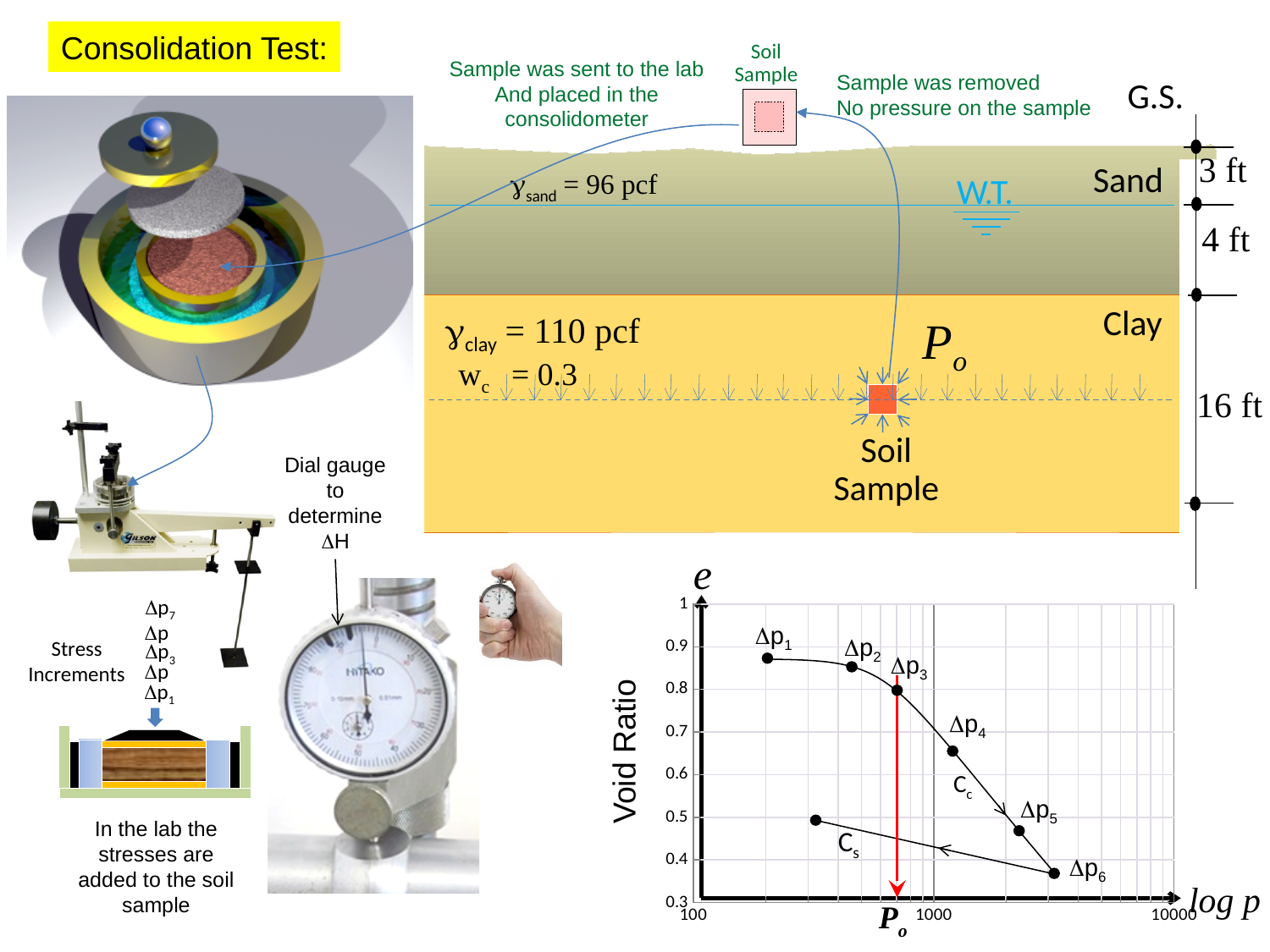
On the void ratio chart, which has the larger void ratio, Δp2 or Δp4? Δp2 On the void ratio chart, which labeled stress increment point has the lowest void ratio? Δp6 What is the label of the vertical axis on the void ratio chart? Void Ratio On the void ratio chart, is the void ratio at Δp1 greater or less than 0.8? greater What is the label of the horizontal axis on the void ratio chart? log p On the void ratio chart, is the void ratio at Δp4 greater or less than 0.7? less On the void ratio chart, is the pressure at Δp5 greater or less than 1000? greater What kind of chart is the void ratio plot at the bottom right of the slide? line chart On the void ratio chart, does the void ratio rise or fall as log p increases from Δp1 to Δp6? fall How many stress increment points (Δp1 to Δp6) are labeled on the void ratio chart? 6 On the void ratio chart, which labeled stress increment point has the highest void ratio? Δp1